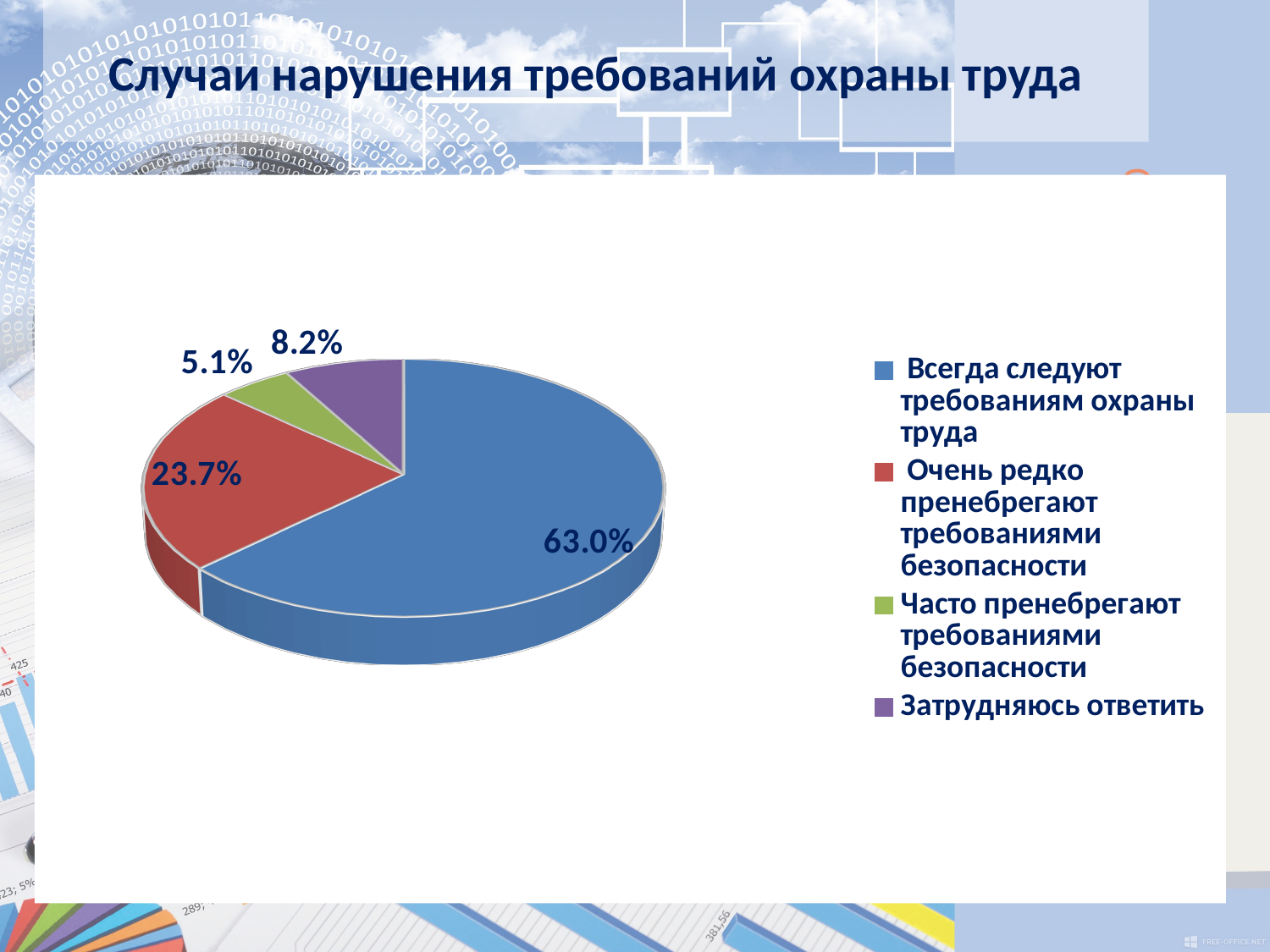
What is the difference in percentage points between the "Всегда следуют требованиям охраны труда" slice and the "Очень редко пренебрегают требованиями безопасности" slice? 39.3 What share of the pie is labelled "Всегда следуют требованиям охраны труда"? 63.0% Which slice is larger: "Затрудняюсь ответить" or "Часто пренебрегают требованиями безопасности"? Затрудняюсь ответить What share of the pie is labelled "Затрудняюсь ответить"? 8.2% What colour is the slice for "Затрудняюсь ответить"? Purple What type of chart is shown on the slide? Pie chart What share of the pie is labelled "Часто пренебрегают требованиями безопасности"? 5.1% How many slices does the pie chart have? 4 Which category has the largest slice of the pie? Всегда следуют требованиям охраны труда What share of the pie is labelled "Очень редко пренебрегают требованиями безопасности"? 23.7% Which category has the smallest slice of the pie? Часто пренебрегают требованиями безопасности What is the title of the slide containing the chart? Случаи нарушения требований охраны труда